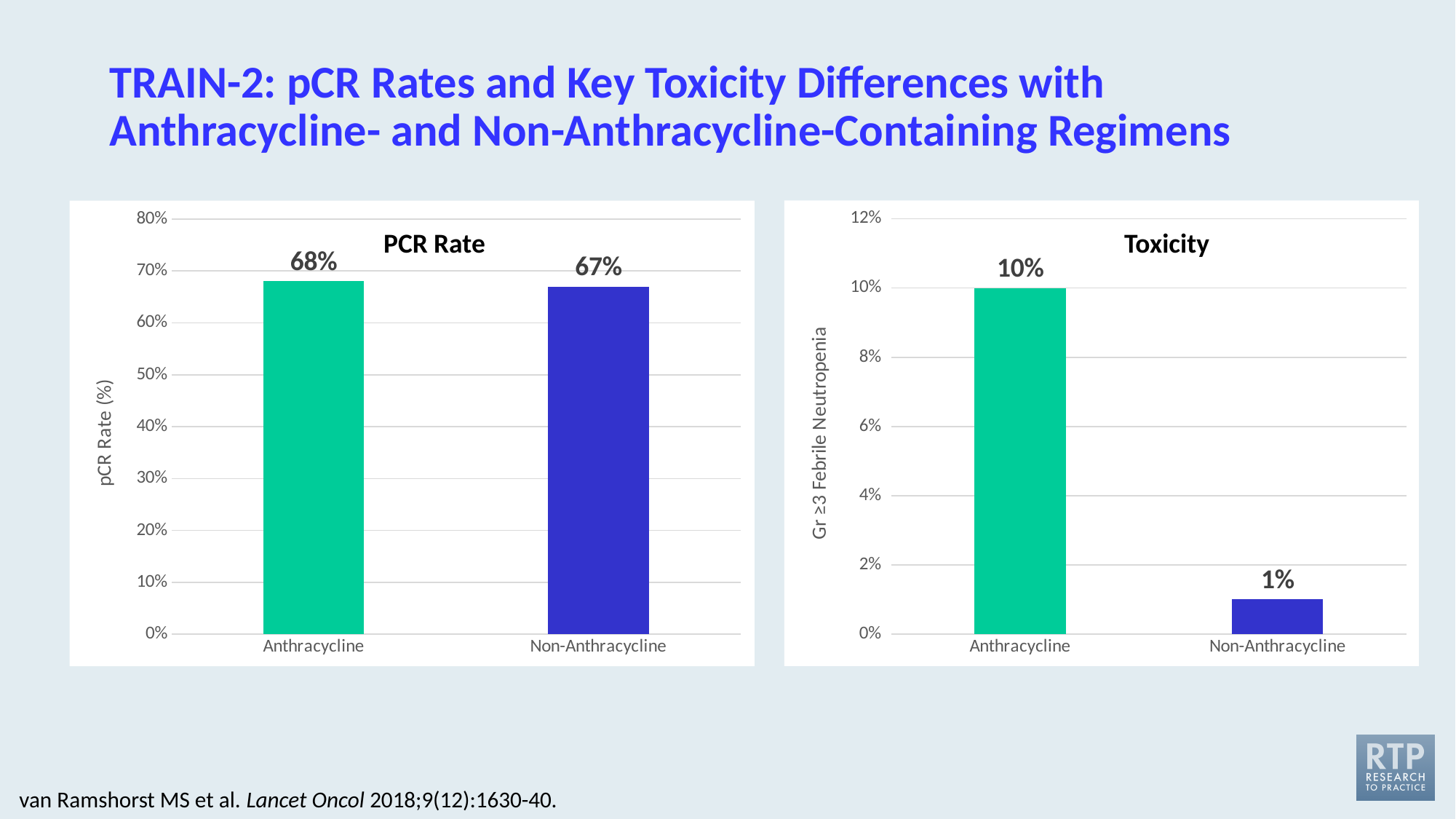
In the Toxicity chart, what is the difference between the Anthracycline and Non-Anthracycline values? 9% In the Toxicity chart, what is the value for Anthracycline? 10% In the Toxicity chart, what is the value for Non-Anthracycline? 1% In the PCR Rate chart, what is the difference between the Anthracycline and Non-Anthracycline values? 1% In the Toxicity chart, which category has the highest value? Anthracycline In the PCR Rate chart, what is the pCR rate for Anthracycline? 68% What kind of chart is the Toxicity chart? bar chart How many categories are shown in the PCR Rate chart? 2 In the Toxicity chart, is the value for Anthracycline greater or less than 8%? greater In the PCR Rate chart, what is the pCR rate for Non-Anthracycline? 67% In the Toxicity chart, which category has the lowest value? Non-Anthracycline What is the y-axis label of the Toxicity chart? Gr ≥3 Febrile Neutropenia